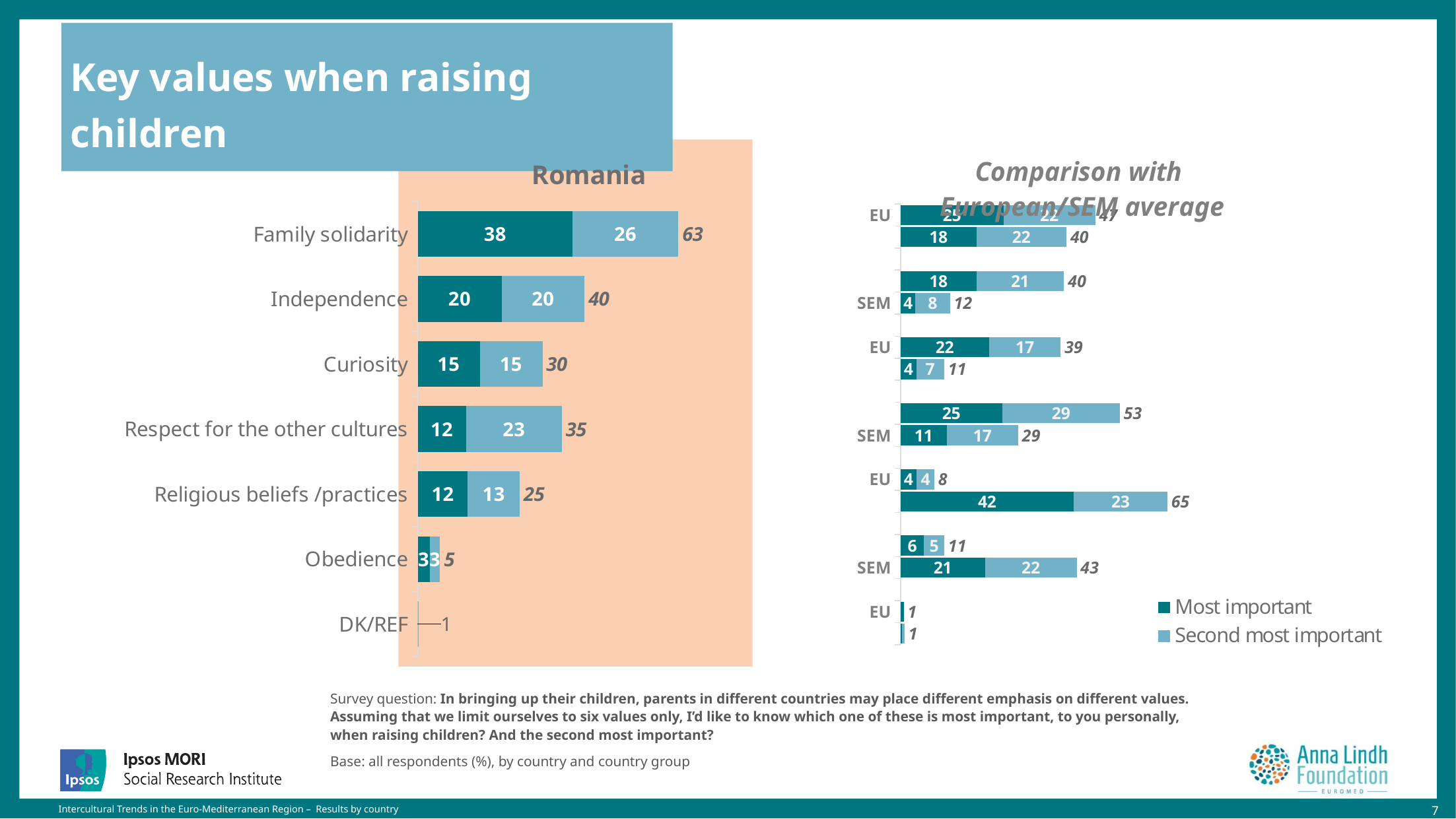
How many series does the legend of the comparison chart list? 2 In the Romania chart, what is the total value for Family solidarity? 63 In the Romania chart, how many categories are shown on the vertical axis? 7 What type of chart is the Romania chart? Stacked bar chart In the comparison chart, what is the 'Most important' value in the SEM bar whose total is 43? 21 In the Romania chart, what is the 'Most important' value for Independence? 20 In the Romania chart, which is larger: the total for Respect for the other cultures or the total for Religious beliefs /practices? Respect for the other cultures In the Romania chart, which value has the highest total? Family solidarity In the Romania chart, what is the 'Second most important' value for Respect for the other cultures? 23 In the Romania chart, what is the difference between the totals for Independence and Curiosity? 10 In the Romania chart, which of the six values (excluding DK/REF) has the lowest total? Obedience In the comparison chart, what is the largest total shown, and is it for EU or SEM? 65, SEM